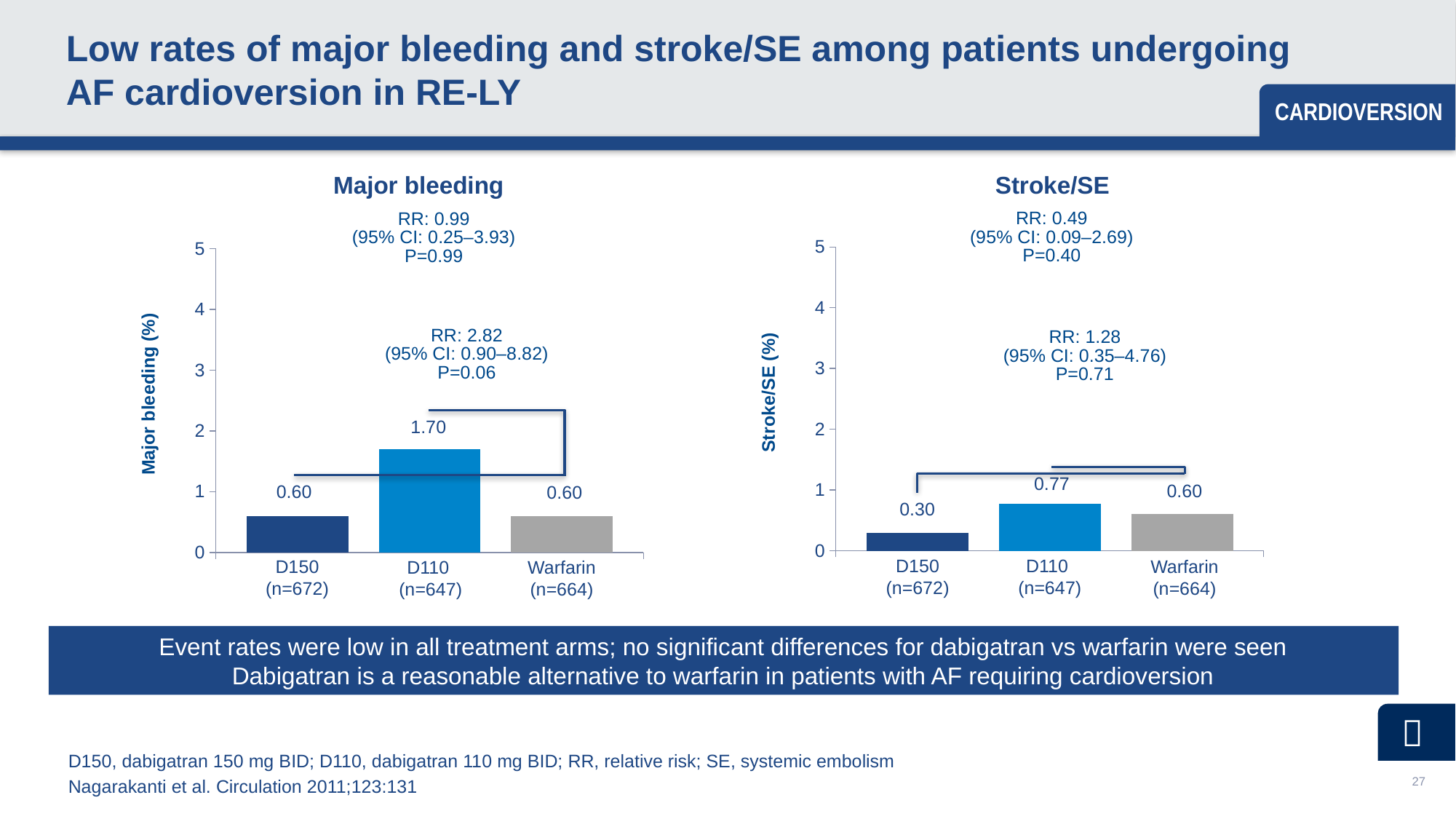
In the Stroke/SE chart, what is the value for D150 (n=672)? 0.30 In the Major bleeding chart, what is the difference between the D110 value and the Warfarin value? 1.10 In the Stroke/SE chart, what is the difference between the Warfarin value and the D150 value? 0.30 In the Major bleeding chart, is the value for D110 greater or less than 1? greater In the Major bleeding chart, which treatment arm has the highest value? D110 (n=647) In the Stroke/SE chart, which treatment arm has the lowest value? D150 (n=672) In the Stroke/SE chart, is the value for D110 or Warfarin larger? D110 In the Stroke/SE chart, what is the value for D110 (n=647)? 0.77 In the Major bleeding chart, what is the value for Warfarin (n=664)? 0.60 What type of chart is the Major bleeding chart? Bar chart How many treatment arms are shown in the Stroke/SE chart? 3 In the Major bleeding chart, what is the value for D110 (n=647)? 1.70